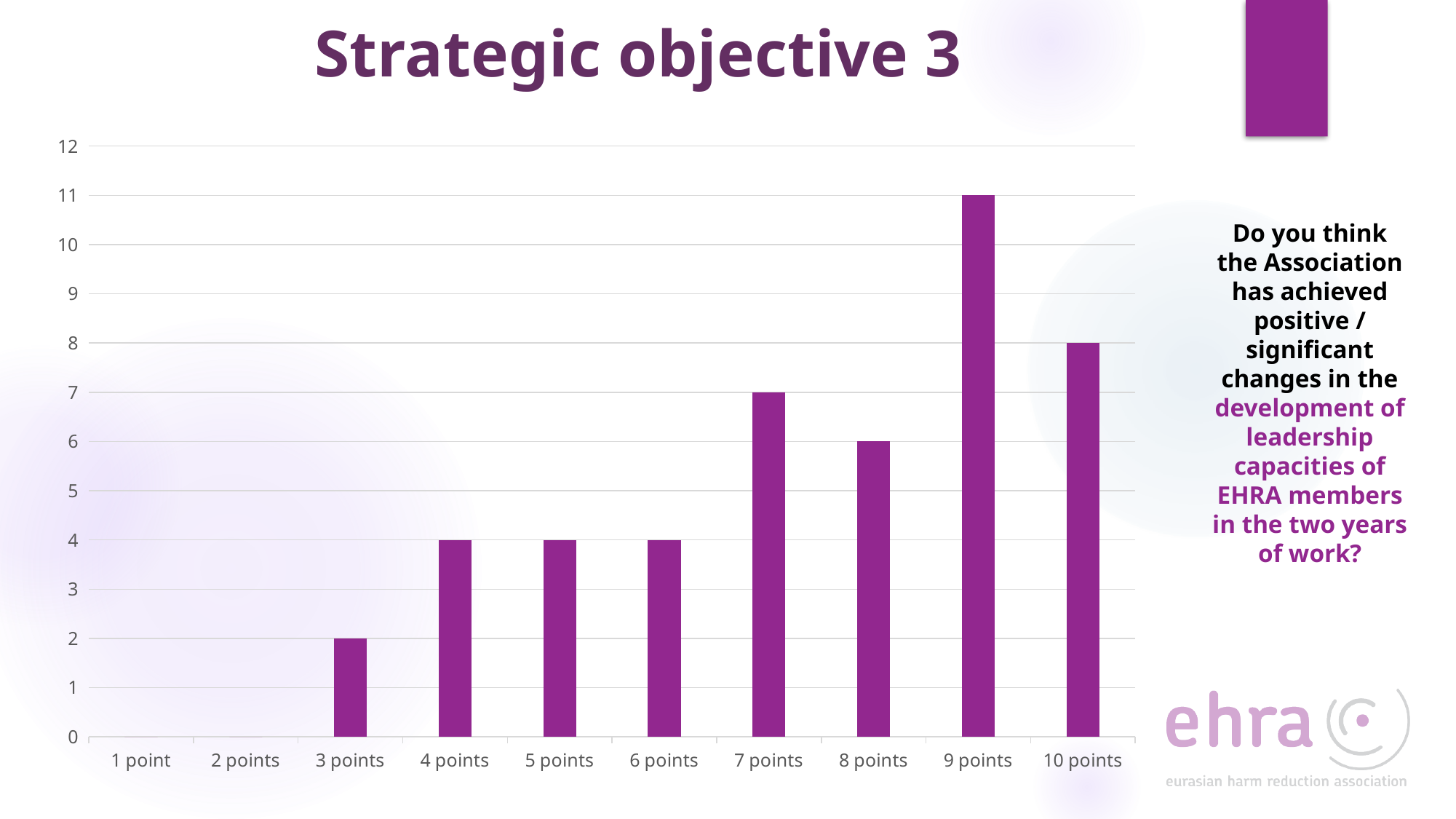
What is the title of the slide containing the chart? Strategic objective 3 Is the value for 9 points greater or less than 10? greater What is the value for 9 points? 11 Which category has the highest value in the chart? 9 points What kind of chart is shown on the slide? bar chart Which categories have a value of 0 in the chart? 1 point and 2 points What is the value for 3 points? 2 Which is larger, the value for 7 points or the value for 8 points? 7 points What is the difference between the values for 9 points and 8 points? 5 What is the value for 7 points? 7 What is the value for 10 points? 8 How many categories are shown on the x axis of the chart? 10